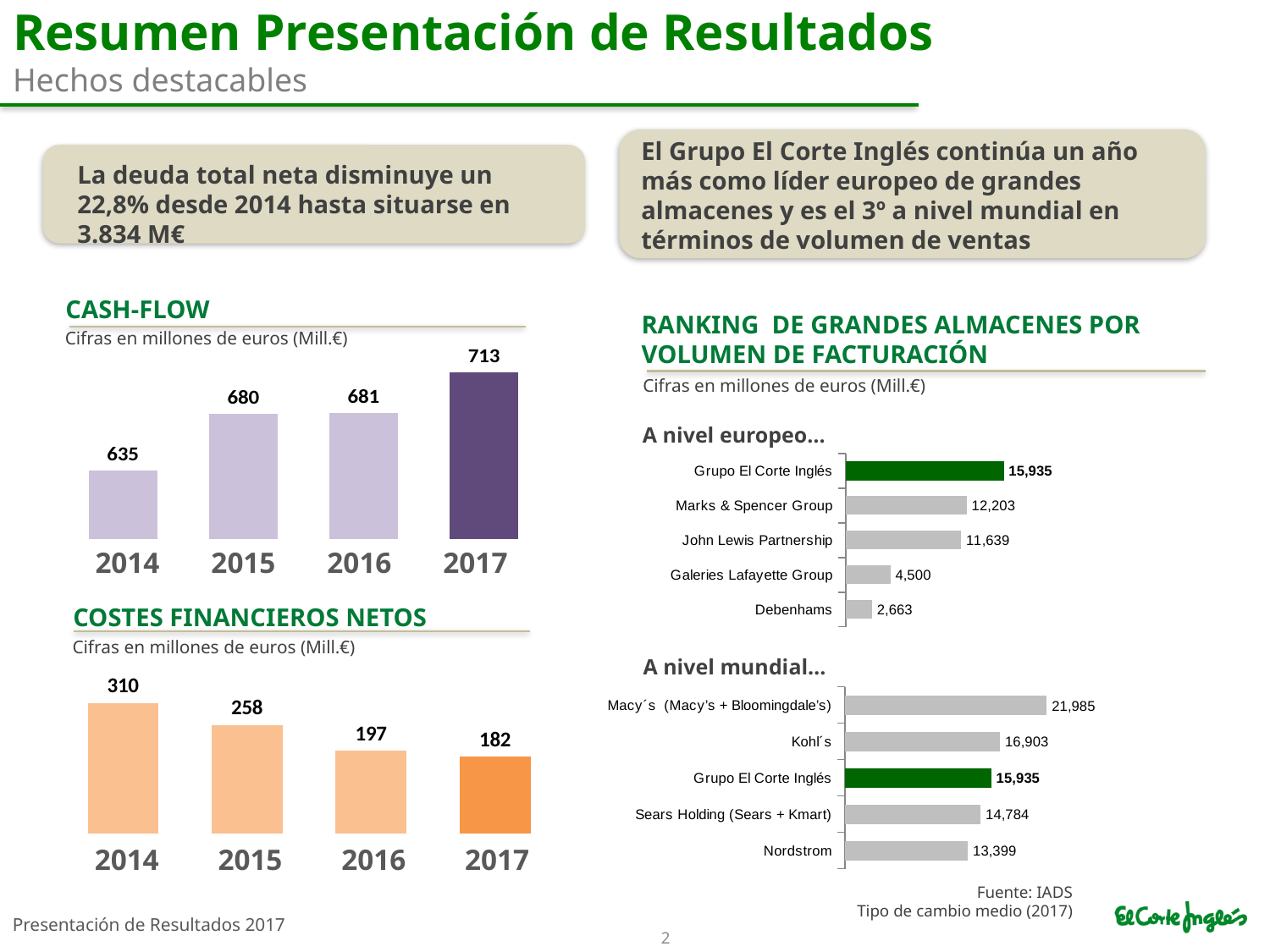
In the CASH-FLOW chart, what is the difference between the 2017 and 2014 values? 78 In the CASH-FLOW chart, what is the value for 2017? 713 In the 'A nivel mundial' ranking chart, which is larger, Kohl's or Sears Holding (Sears + Kmart)? Kohl's In the 'A nivel europeo' ranking chart, what is the value for Marks & Spencer Group? 12,203 In the 'A nivel europeo' ranking chart, which company has the lowest value? Debenhams In the CASH-FLOW chart, do the values rise or fall from 2014 to 2017? rise In the CASH-FLOW chart, which year has the lowest value? 2014 In the 'A nivel mundial' ranking chart, what is the difference between Macy's (Macy's + Bloomingdale's) and Nordstrom? 8,586 In the COSTES FINANCIEROS NETOS chart, which year has the highest value? 2014 In the COSTES FINANCIEROS NETOS chart, what is the value for 2015? 258 In the COSTES FINANCIEROS NETOS chart, how many years are shown? 4 In the COSTES FINANCIEROS NETOS chart, what is the difference between the 2014 and 2017 values? 128